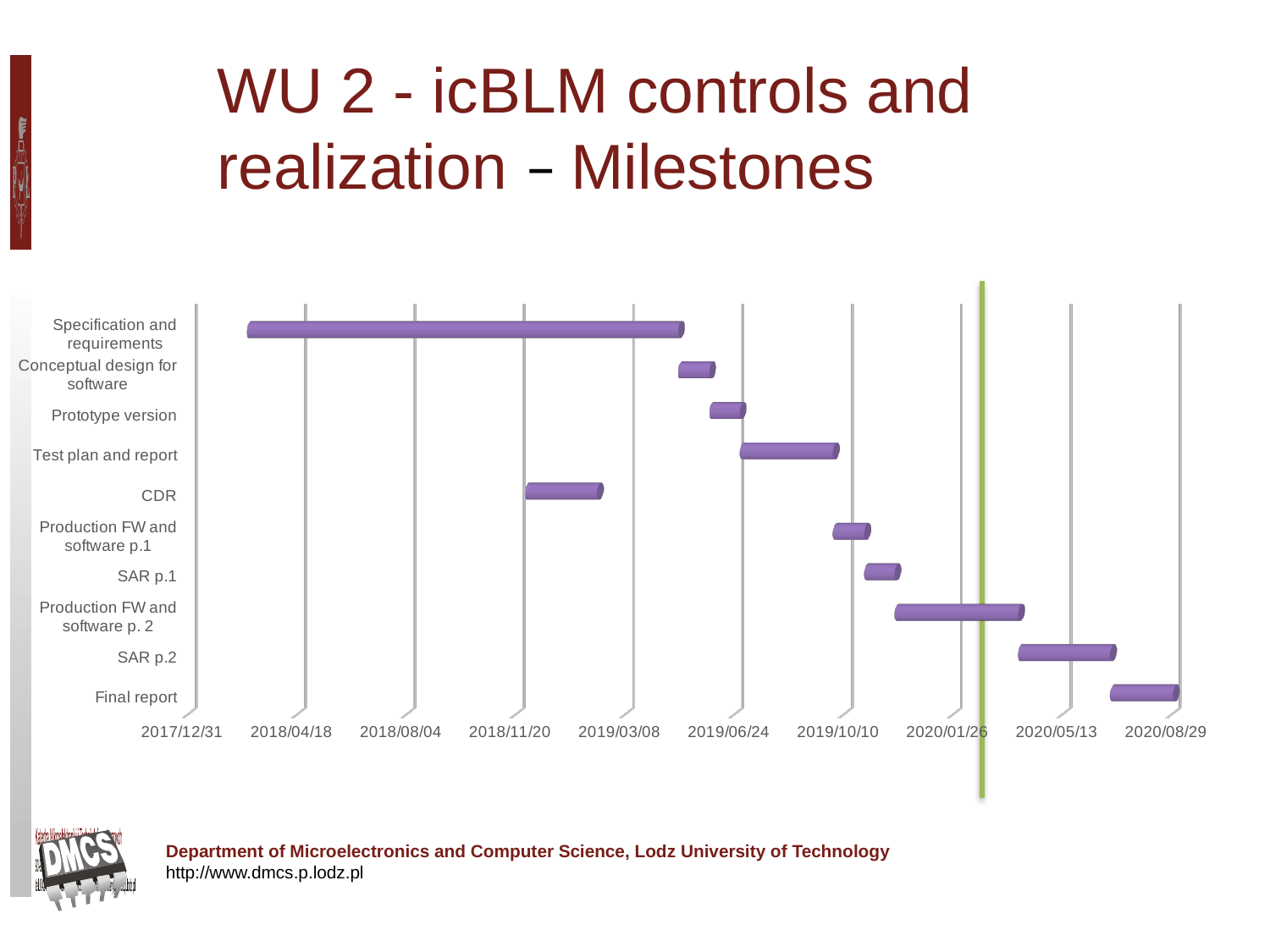
What is the last date label shown on the horizontal axis? 2020/08/29 Which bar is longer, Production FW and software p.1 or Production FW and software p. 2? Production FW and software p. 2 Does the Specification and requirements bar end before or after 2019/06/24? before Which task's bar starts earliest on the time axis? Specification and requirements Does the Final report bar start before or after 2020/05/13? after Which task has the longest bar in the chart? Specification and requirements Which task's bar is positioned latest in time on the chart? Final report What kind of chart is shown on the slide? Bar chart (Gantt chart) Which bar is longer, Test plan and report or SAR p.1? Test plan and report How many tasks (categories) are listed on the vertical axis of the chart? 10 Does the SAR p.2 bar start before or after 2020/01/26? after What is the first date label shown on the horizontal axis? 2017/12/31